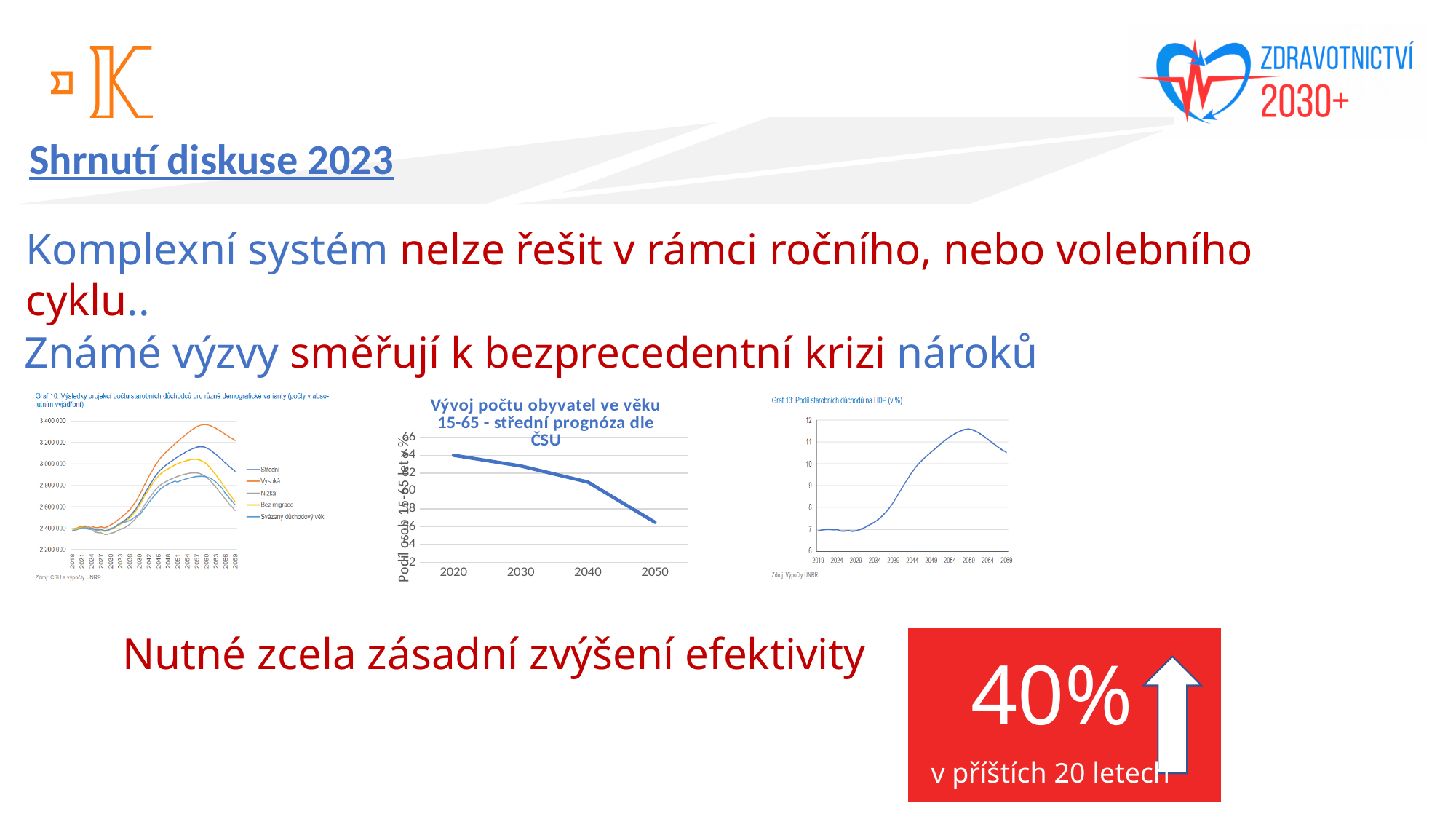
How many series does the legend of the left chart (Graf 10) list? 5 In the right chart (Graf 13), is the peak value around 2059 greater or less than 11? greater What is the title of the right chart? Graf 13: Podíl starobních důchodů na HDP (v %) What kind of chart is the middle chart titled 'Vývoj počtu obyvatel ve věku 15-65 - střední prognóza dle ČSÚ'? line chart In the right chart (Graf 13), is the value for 2019 greater or less than 8? less In the left chart (Graf 10), which series has the highest value around 2060? Vysoká In the middle chart 'Vývoj počtu obyvatel ve věku 15-65', is the value for 2050 greater or less than 58? less What kind of chart is the right chart (Graf 13: Podíl starobních důchodů na HDP)? line chart How many years are labelled on the x axis of the middle chart 'Vývoj počtu obyvatel ve věku 15-65'? 4 In the middle chart 'Vývoj počtu obyvatel ve věku 15-65', do the values rise or fall from 2020 to 2050? fall